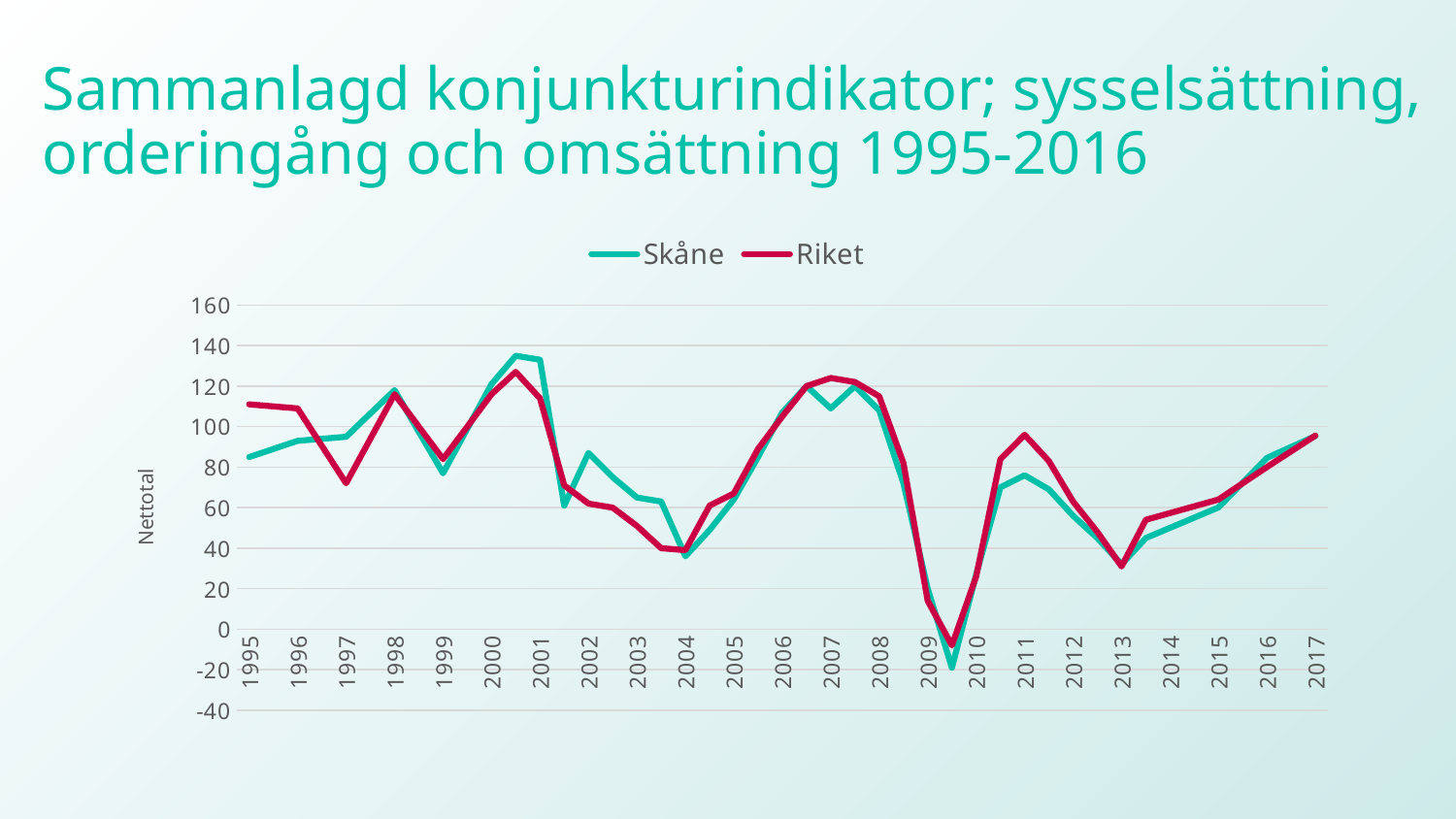
Is the value for Riket in 1995 greater or less than 100? greater Which series has the higher value in 2011, Skåne or Riket? Riket Is the lowest value for Skåne, around 2009, greater or less than 0? less How many series does the legend list? 2 What is the label on the vertical axis? Nettotal Do the values for both series rise or fall from 2013 to 2017? rise Is the value for Skåne in 1995 greater or less than 100? less What are the two series named in the legend? Skåne and Riket Which series has the higher value in 1995, Skåne or Riket? Riket How many year labels are shown along the x axis? 23 What kind of chart is shown on the slide? line chart